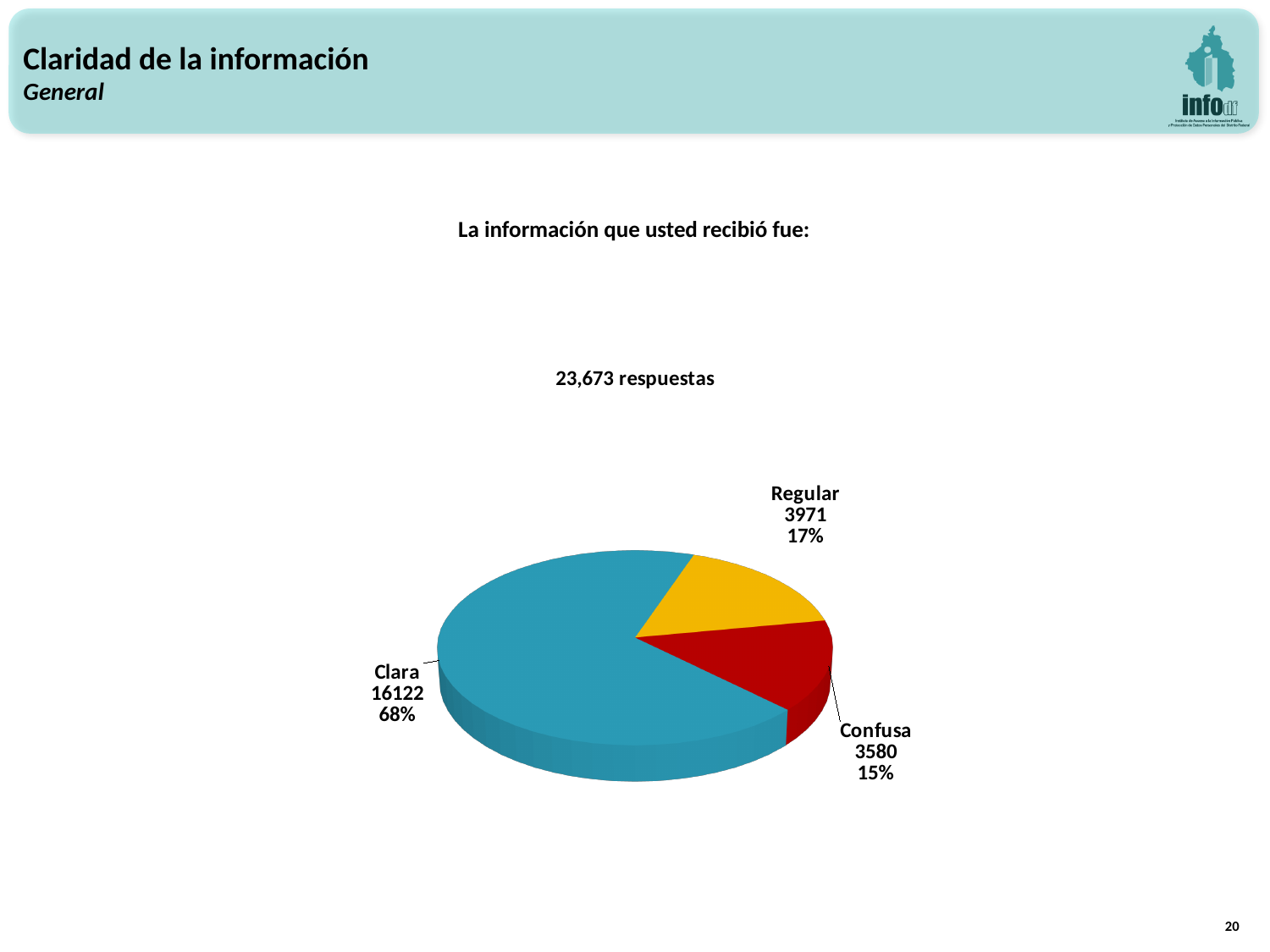
What is the value for Confusa? 3580 What is the difference between the values for Regular and Confusa? 391 How many total responses (respuestas) does the slide report? 23,673 respuestas Which category has the smallest slice? Confusa What share of the pie does Confusa represent? 15% What kind of chart is shown on the slide? pie chart Which category has the largest slice? Clara What is the value for Regular? 3971 What share of the pie does Clara represent? 68% How many slices does the pie chart have? 3 What is the value for Clara? 16122 Which is larger, the value for Clara or the value for Regular? Clara